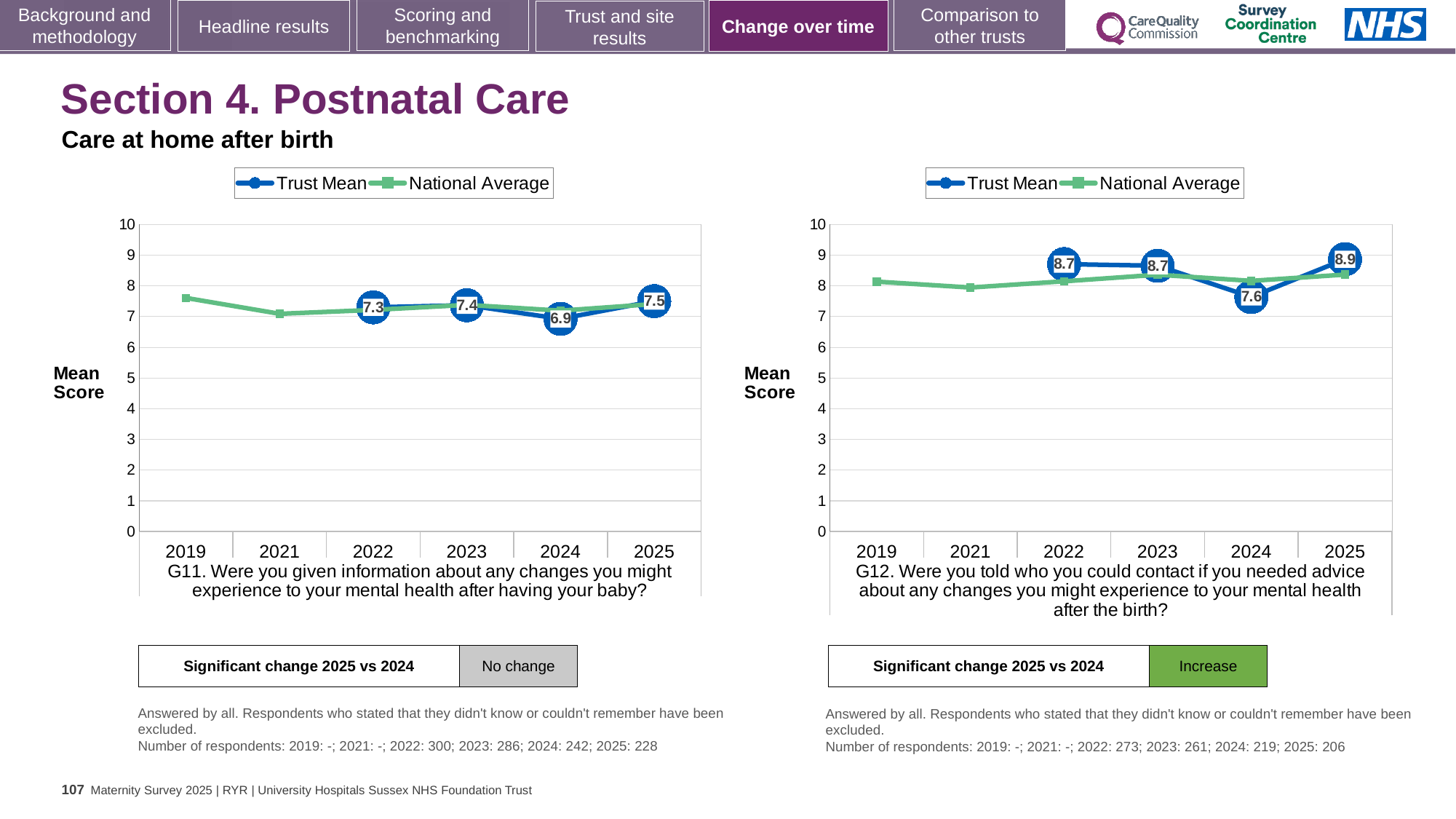
In the G11 chart (left), what is the difference between the Trust Mean for 2025 and the Trust Mean for 2024? 0.6 How many series does the legend of the G12 chart (right) list? 2 In the G12 chart (right), which year has the highest Trust Mean? 2025 In the G12 chart (right), what is the Trust Mean for 2025? 8.9 In the G12 chart (right), which year has the lowest Trust Mean? 2024 What type of chart is the G11 chart (left)? Line chart In the G11 chart (left), what is the Trust Mean for 2024? 6.9 In the G11 chart (left), what is the Trust Mean for 2025? 7.5 In the G12 chart (right), what is the difference between the Trust Mean for 2025 and the Trust Mean for 2024? 1.3 In the G12 chart (right), what is the Trust Mean for 2024? 7.6 In the G11 chart (left), is the National Average for 2019 greater or less than 7? greater In the G11 chart (left), is the Trust Mean higher in 2023 or in 2024? 2023